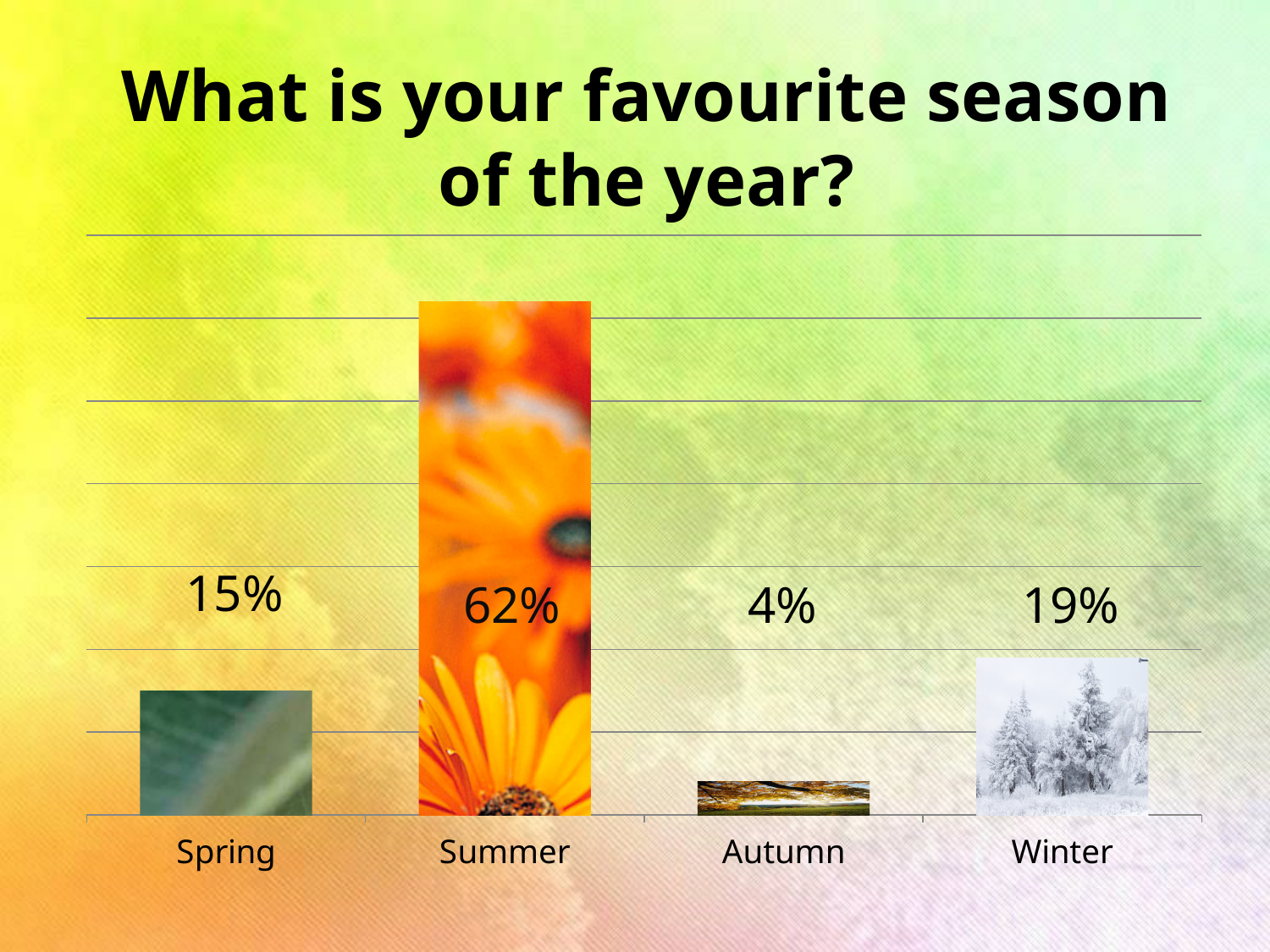
Which season has the highest value? Summer What is the value shown for Autumn? 4% How many seasons are shown on the chart? 4 What percentage of respondents chose Summer as their favourite season? 62% What kind of chart is shown on the slide? Bar chart What is the difference between the values for Winter and Spring? 4% What is the value shown for Spring? 15% Which has a larger value, Spring or Winter? Winter What is the difference between the values for Summer and Winter? 43% Which season has the lowest value? Autumn What is the value shown for Winter? 19% What is the title of the slide? What is your favourite season of the year?